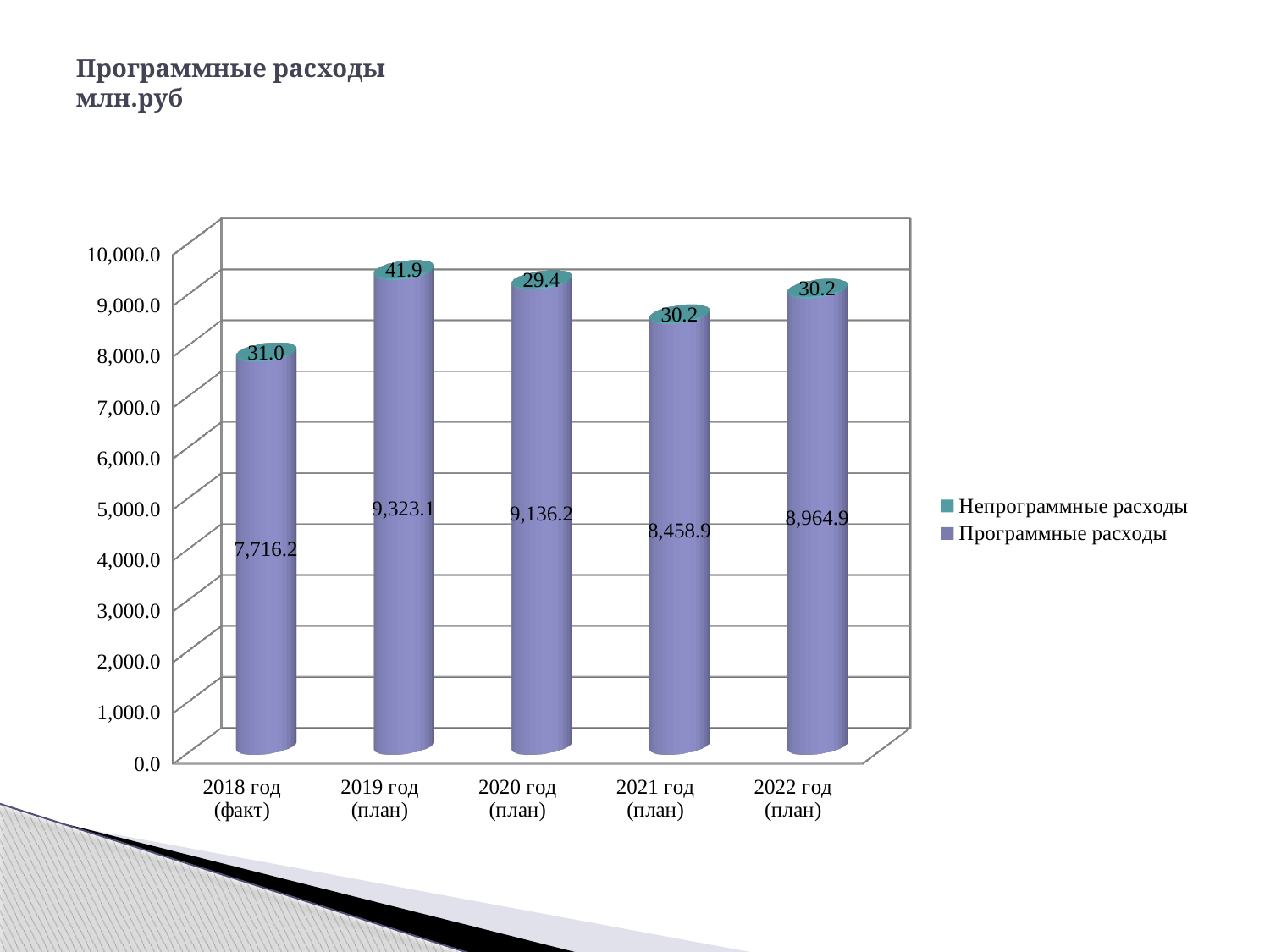
What unit is stated in the slide title for the expenses? млн.руб Which year has the lowest value of Непрограммные расходы? 2020 год (план) What is the value of Программные расходы for 2021 год (план)? 8,458.9 Which year has the highest value of Программные расходы? 2019 год (план) What is the total of the stacked bar for 2018 год (факт)? 7,747.2 What is the value of Программные расходы for 2018 год (факт)? 7,716.2 What is the value of Непрограммные расходы for 2019 год (план)? 41.9 How many year categories are shown on the x axis? 5 What kind of chart is shown on the slide? Stacked bar chart How many series does the legend list? 2 What is the difference between Программные расходы in 2019 год (план) and 2020 год (план)? 186.9 Which is larger: Программные расходы in 2022 год (план) or in 2021 год (план)? 2022 год (план)